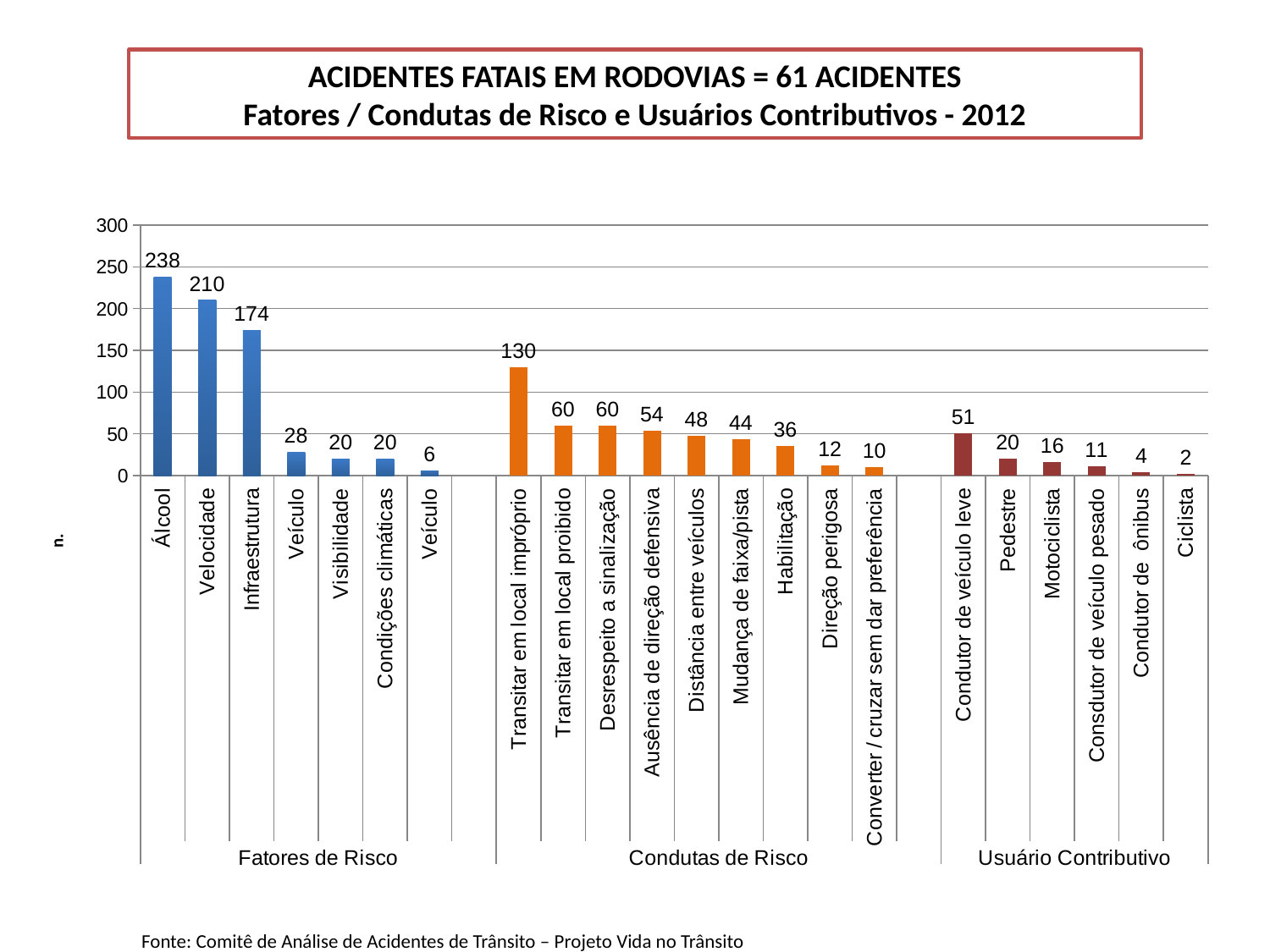
What is the value for Álcool? 238 What is the value for Transitar em local impróprio? 130 What is the value for Habilitação? 36 Is the value for Infraestrutura greater or less than 150? greater What is the difference between the values for Álcool and Velocidade? 28 How many bars are plotted in the chart? 22 What type of chart is shown on the slide? bar chart Which is larger, the value for Pedestre or the value for Motociclista? Pedestre Which category has the highest value in the chart? Álcool What are the three group labels shown along the bottom of the chart? Fatores de Risco, Condutas de Risco, Usuário Contributivo What is the value for Condutor de veículo leve? 51 Which category has the lowest value in the chart? Ciclista